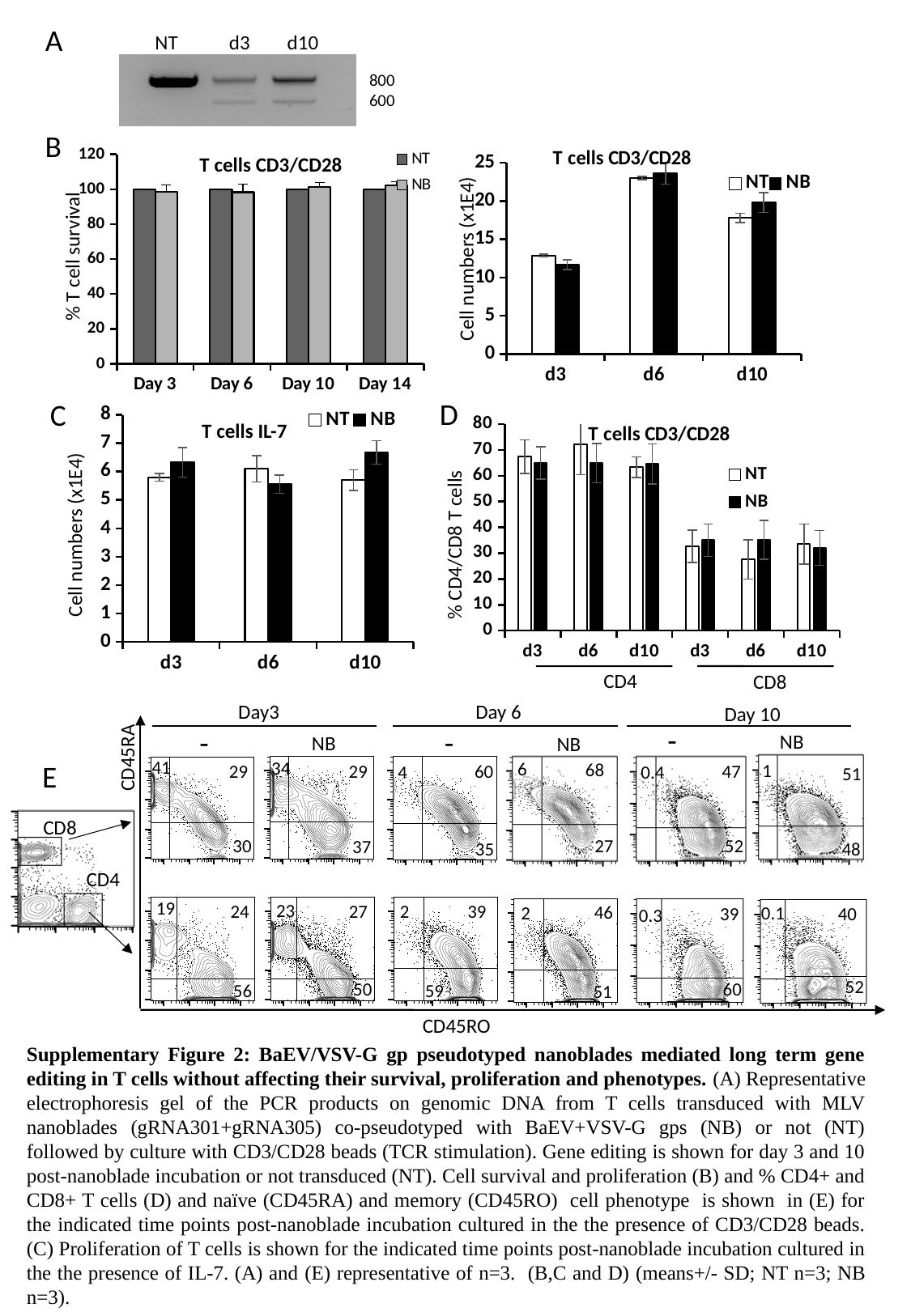
In the 'T cells IL-7' chart (panel C), is the NB value for d10 greater or less than 6? greater In the 'Cell numbers (x1E4)' T cells CD3/CD28 chart (panel B, right), which time point has the highest NT value? d6 In the '% CD4/CD8 T cells' chart (panel D), is the NT value for CD4 at d6 greater or less than 60? greater In the '% T cell survival' chart (panel B, left), is the NT value for Day 3 greater or less than 80? greater In the '% CD4/CD8 T cells' chart (panel D), which is larger for NT at d3: CD4 or CD8? CD4 In the '% T cell survival' chart (panel B, left), how many day categories are shown on the x axis? 4 What kind of chart is the 'Cell numbers (x1E4)' T cells CD3/CD28 chart in panel B (right)? bar chart In the 'Cell numbers (x1E4)' T cells CD3/CD28 chart (panel B, right), which is larger for NT: d6 or d10? d6 In the '% T cell survival' chart (panel B, left), how many series does the legend list? 2 In the 'T cells IL-7' chart (panel C), how many time point categories are on the x axis? 3